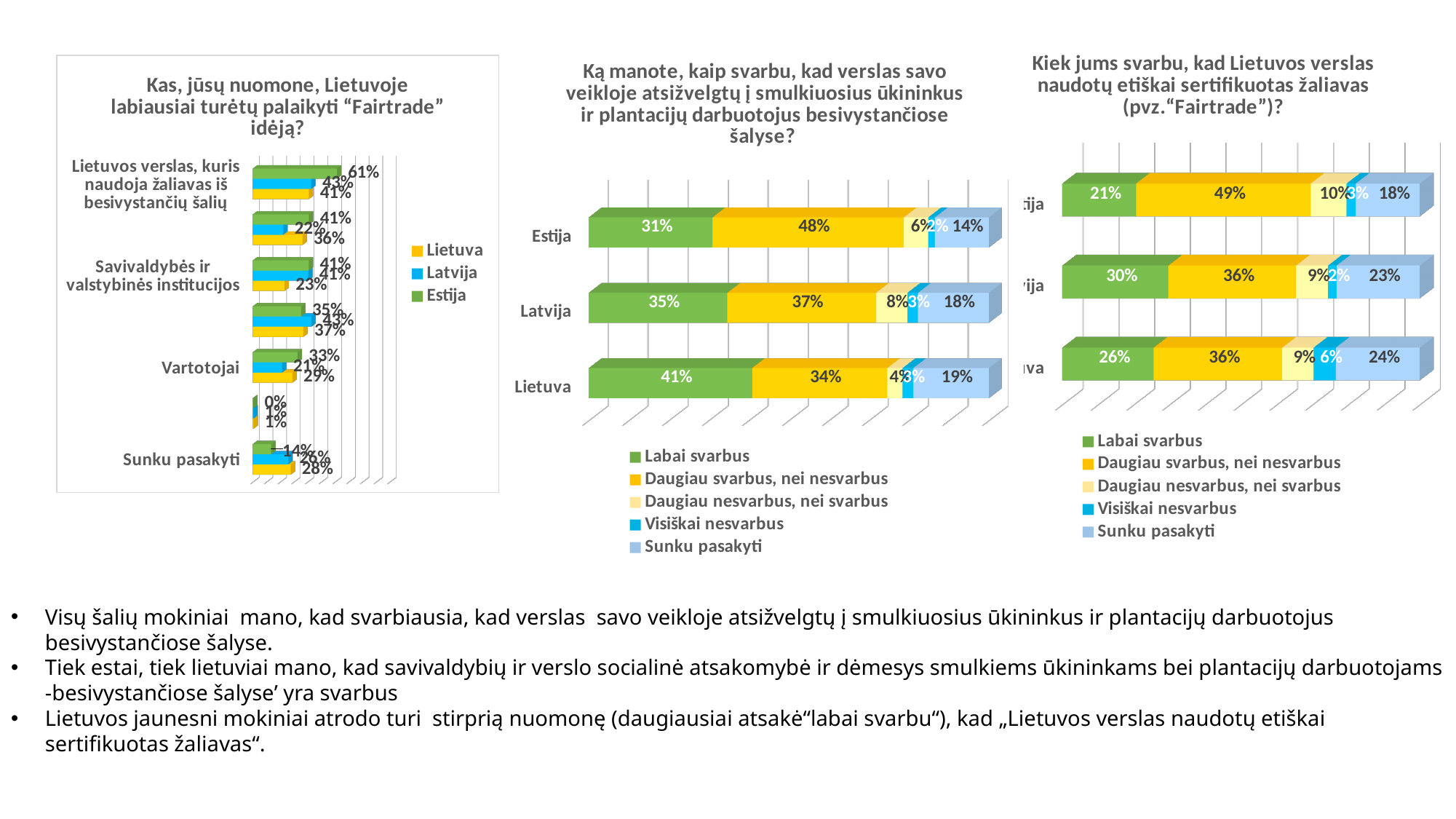
In the left chart ("Kas, jūsų nuomone, Lietuvoje labiausiai turėtų palaikyti 'Fairtrade' idėją?"), what is the Estija value for "Lietuvos verslas, kuris naudoja žaliavas iš besivystančių šalių"? 61% In the right chart, is the "Labai svarbus" value larger for the middle bar (Latvija) or the bottom bar (Lietuva)? Latvija In the middle chart ("Ką manote, kaip svarbu, kad verslas savo veikloje atsižvelgtų..."), what percentage of respondents in Lietuva answered "Labai svarbus"? 41% In the middle chart, what is the difference between the "Labai svarbus" values for Lietuva and Estija? 10% In the right chart ("Kiek jums svarbu, kad Lietuvos verslas naudotų etiškai sertifikuotas žaliavas..."), what is the "Daugiau svarbus, nei nesvarbus" value for the top bar (Estija)? 49% In the middle chart, which country has the lowest "Sunku pasakyti" share? Estija In the middle chart, what is the "Daugiau svarbus, nei nesvarbus" value for Estija? 48% In the right chart, what is the "Visiškai nesvarbus" value for the bottom bar (Lietuva)? 6% How many series does the legend of the left chart list? 3 How many series does the legend of the middle chart list? 5 In the middle chart, which country has the highest "Labai svarbus" share? Lietuva What type of chart is the middle chart? Stacked bar chart